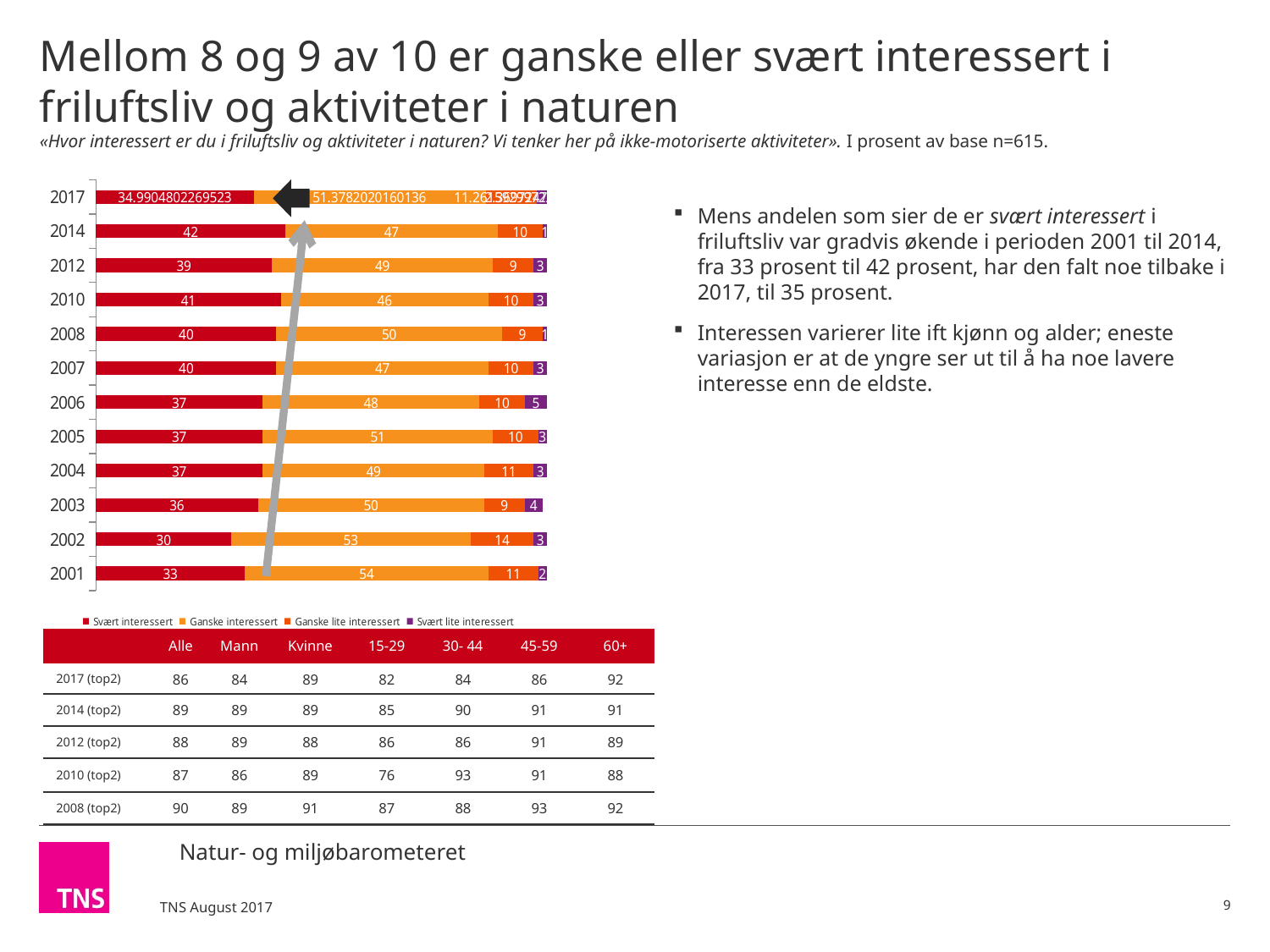
What is the difference between the Svært interessert values for 2014 and 2001? 9 What is the value for Svært lite interessert in 2006? 5 What kind of chart is shown on the slide? Stacked bar chart How many series does the chart legend list? 4 What is the total of the stacked bar for 2014? 100 What is the value for Ganske interessert in 2001? 54 What is the value for Ganske lite interessert in 2002? 14 Which year has the lowest value for Svært interessert? 2002 Which year has the highest value for Ganske interessert? 2001 What is the value for Svært interessert in 2014? 42 Which is larger, the Ganske interessert value for 2002 or for 2014? 2002 How many years are plotted in the chart? 12